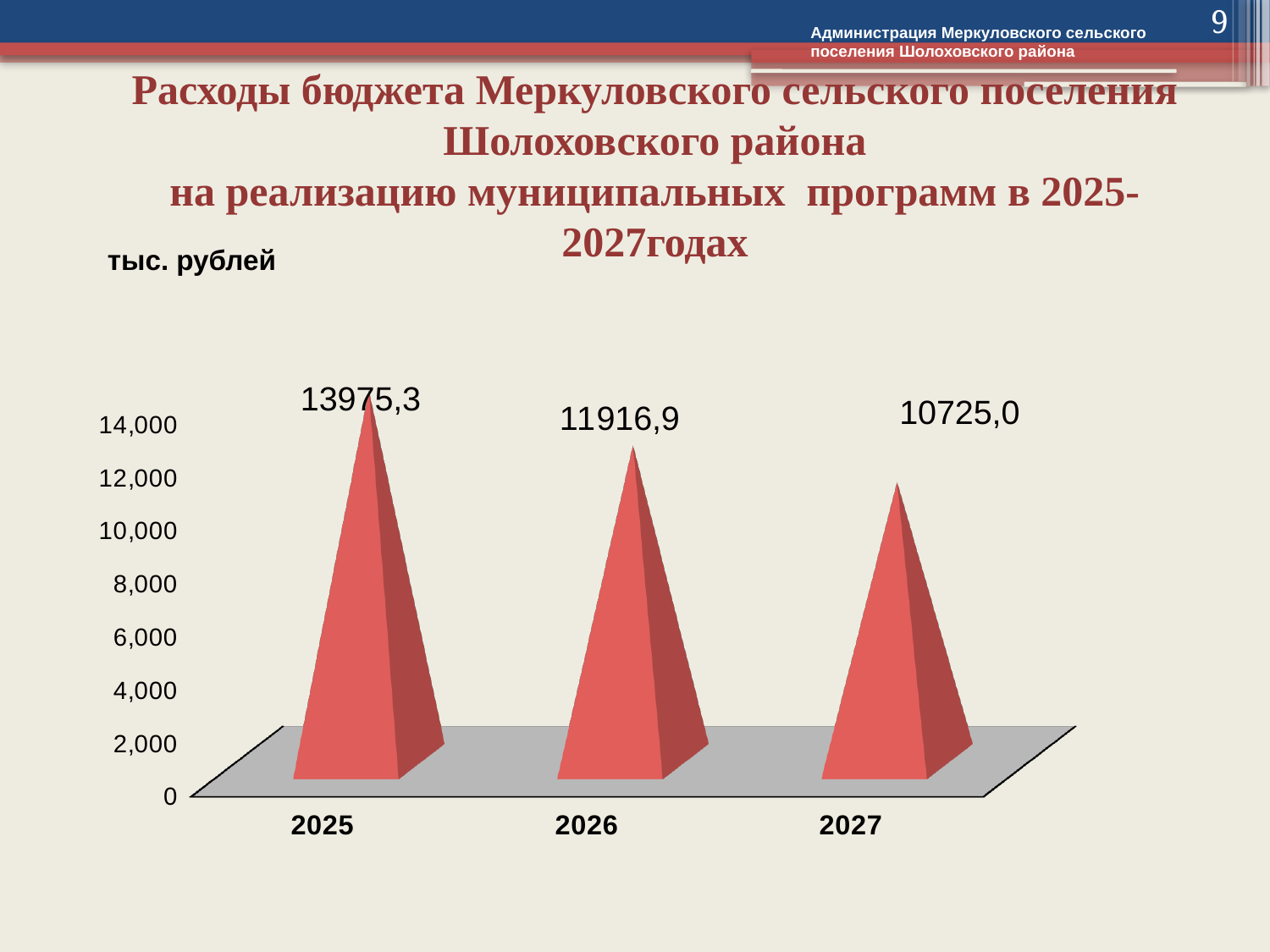
На сколько значение 2025 года больше значения 2026 года? 2058,4 Значение для 2027 года больше или меньше 12,000? меньше Какое значение показано на диаграмме для 2026 года? 11916,9 Сколько лет (категорий) показано на диаграмме? 3 В каком году расходы на реализацию муниципальных программ наибольшие? 2025 Какого типа эта диаграмма? столбчатая (bar chart) Как изменяются значения на диаграмме от 2025 к 2027 году — растут или снижаются? снижаются Какое значение расходов на реализацию муниципальных программ показано на диаграмме для 2025 года? 13975,3 В каком году расходы на реализацию муниципальных программ наименьшие? 2027 На сколько значение 2026 года больше значения 2027 года? 1191,9 Какое значение показано на диаграмме для 2027 года? 10725,0 Какое значение больше: за 2026 год или за 2027 год? 2026